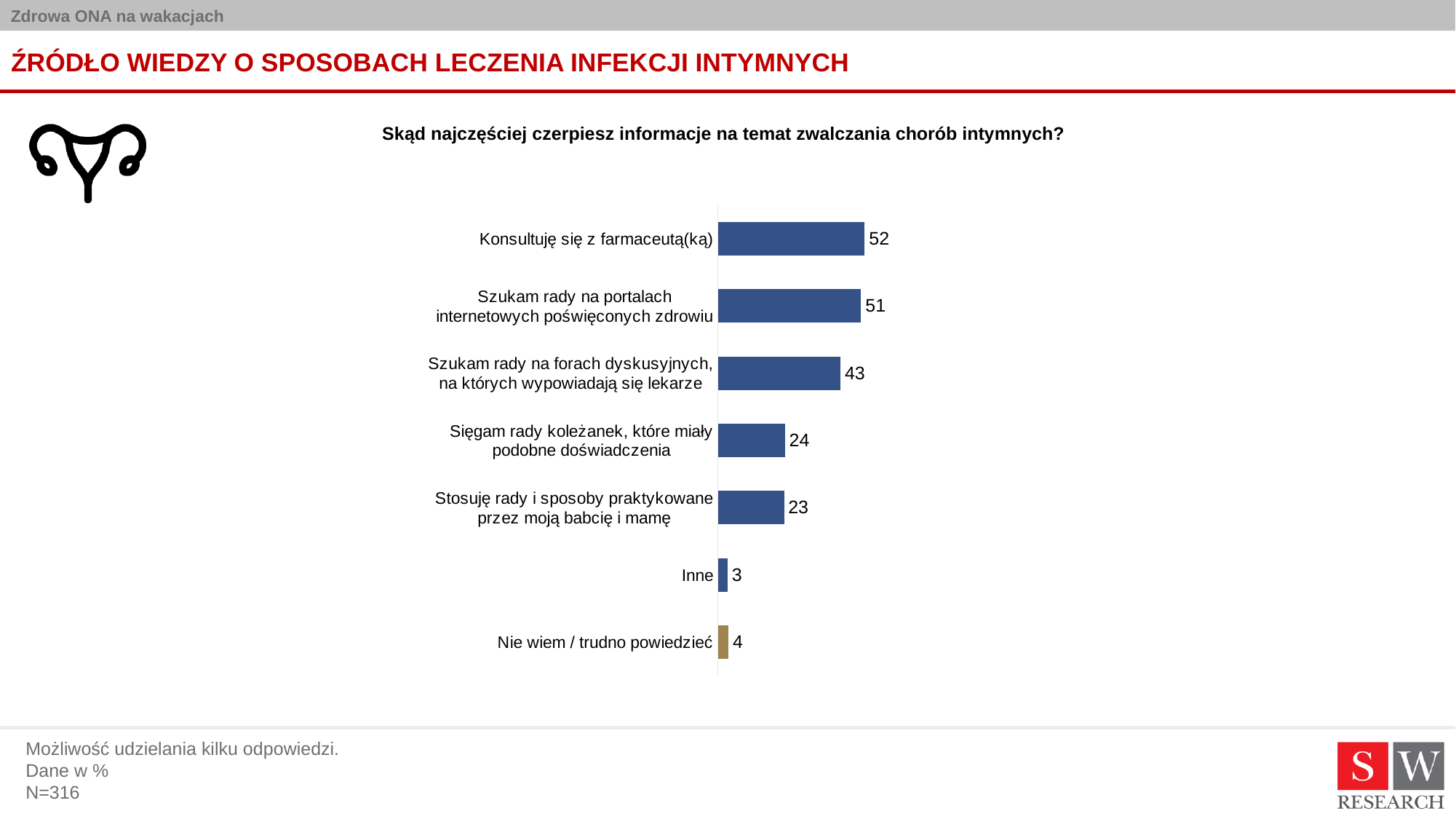
How many categories are shown in the chart? 7 Which category has the highest value? Konsultuję się z farmaceutą(ką) What kind of chart is shown on the slide? Bar chart What question is shown as the chart's title? Skąd najczęściej czerpiesz informacje na temat zwalczania chorób intymnych? Which category's bar is shown in a different colour (brown) from the others? Nie wiem / trudno powiedzieć Which is larger: the value for "Sięgam rady koleżanek, które miały podobne doświadczenia" or the value for "Stosuję rady i sposoby praktykowane przez moją babcię i mamę"? Sięgam rady koleżanek, które miały podobne doświadczenia What value is shown for "Konsultuję się z farmaceutą(ką)"? 52 What value is shown for "Nie wiem / trudno powiedzieć"? 4 What is the difference between the values for "Szukam rady na portalach internetowych poświęconych zdrowiu" and "Sięgam rady koleżanek, które miały podobne doświadczenia"? 27 What value is shown for "Stosuję rady i sposoby praktykowane przez moją babcię i mamę"? 23 Which category has the lowest value? Inne What value is shown for "Szukam rady na forach dyskusyjnych, na których wypowiadają się lekarze"? 43